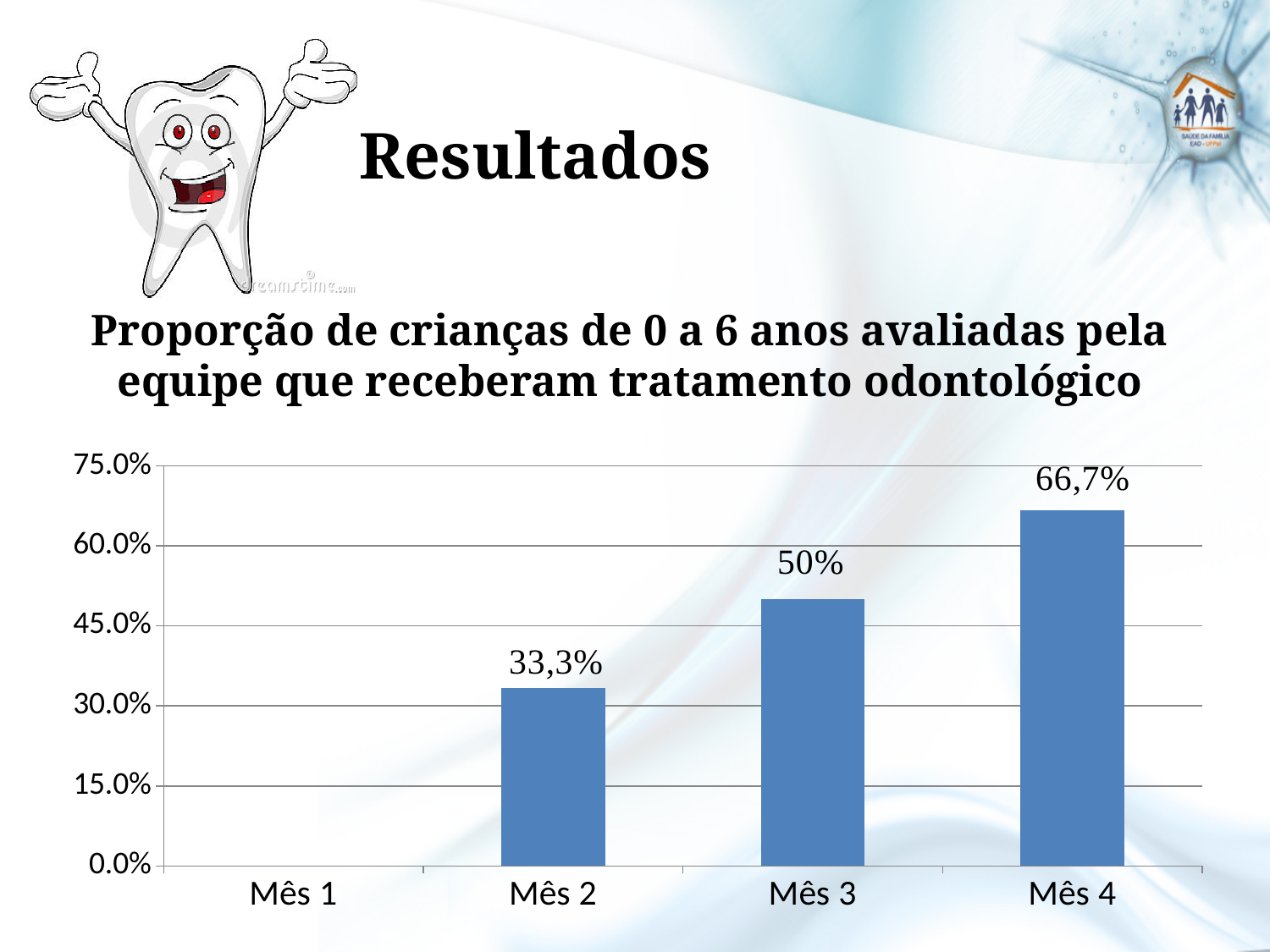
What is the difference between the values for Mês 3 and Mês 2? 16,7% How many months are shown on the x axis? 4 Do the values rise or fall from Mês 2 to Mês 4? rise What is the value for Mês 4? 66,7% Which month has the highest proportion? Mês 4 What is the difference between the values for Mês 4 and Mês 2? 33,3% Among the months with a visible bar, which has the lowest value? Mês 2 What kind of chart is shown on the slide? bar chart What is the value for Mês 3? 50% Which is larger, the value for Mês 3 or the value for Mês 2? Mês 3 Is the value for Mês 4 greater or less than 60.0%? greater What is the value for Mês 2? 33,3%